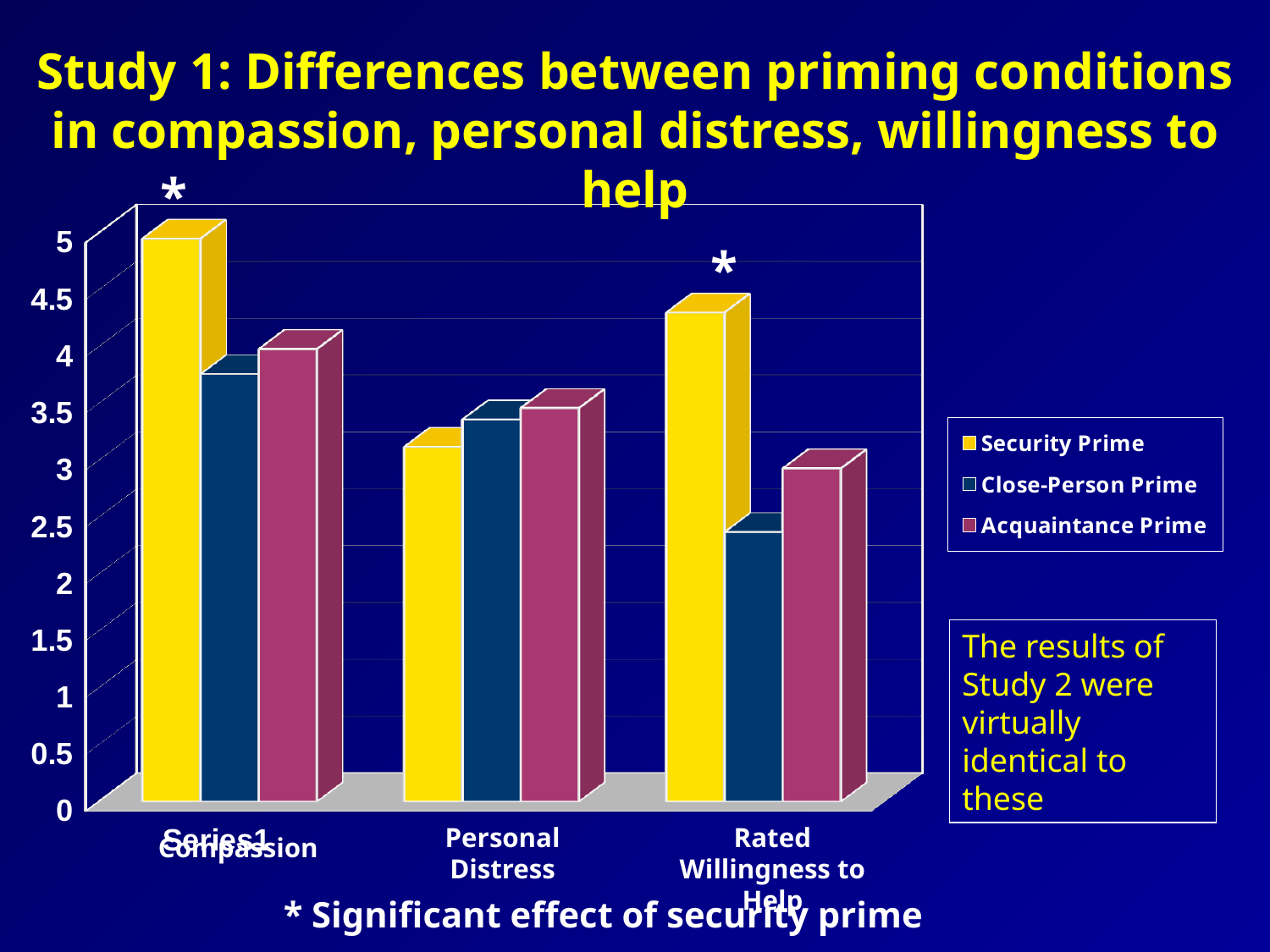
How many series does the legend list? 3 Which series has the highest value for Compassion? Security Prime Is the Security Prime value for Compassion greater or less than 4.5? greater Which is larger: the Security Prime value for Compassion or the Security Prime value for Personal Distress? Compassion How many categories are shown along the x axis? 3 Is the Security Prime value for Personal Distress greater or less than 3.5? less Is the Security Prime value for Rated Willingness to Help greater or less than 4? greater What kind of chart is shown on the slide? bar chart Which series has the lowest value for Personal Distress? Security Prime Which series has the lowest value for Rated Willingness to Help? Close-Person Prime What colour represents the Security Prime series in the legend? yellow